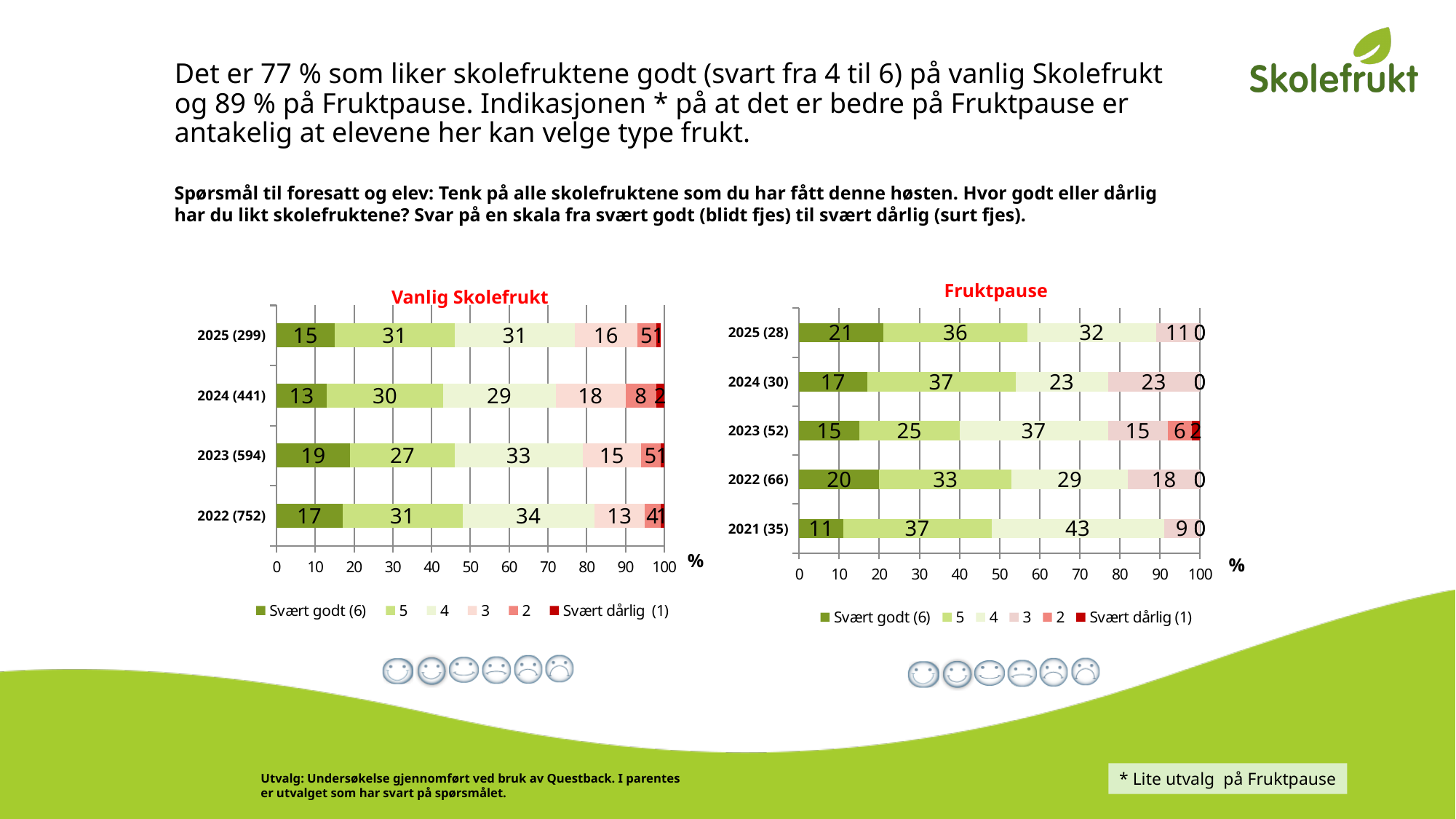
In the Fruktpause chart, which year has the highest value for 'Svært godt (6)'? 2025 (28) In the Vanlig Skolefrukt chart, which year has the lowest value for 'Svært godt (6)'? 2024 (441) In the Fruktpause chart, what is the value for '3' in 2022 (66)? 18 How many series does the legend of the Vanlig Skolefrukt chart list? 6 In the Vanlig Skolefrukt chart, which is larger: the '4' value for 2022 (752) or for 2024 (441)? 2022 (752) In the Vanlig Skolefrukt chart, what is the value for 'Svært godt (6)' in 2023 (594)? 19 What type of chart is the Fruktpause chart? Stacked bar chart What is the title of the chart on the left side of the slide? Vanlig Skolefrukt How many years are shown in the Fruktpause chart? 5 In the Fruktpause chart, what is the difference between the '5' values for 2024 (30) and 2023 (52)? 12 In the Fruktpause chart, what is the value for '4' in 2021 (35)? 43 In the Vanlig Skolefrukt chart, what is the value for '2' in 2024 (441)? 8